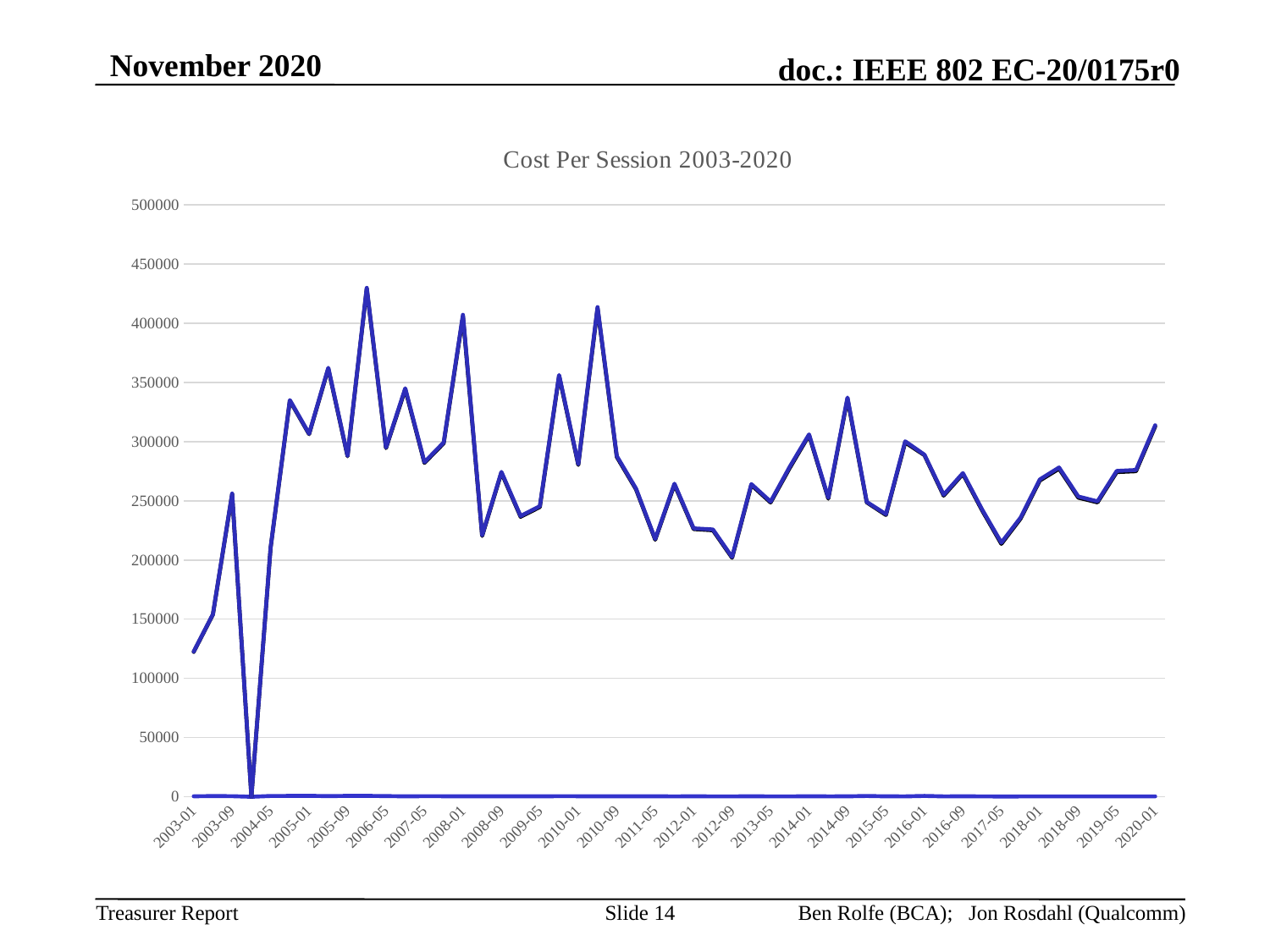
Which has the larger value, 2003-01 or 2020-01? 2020-01 What kind of chart is shown on the slide? line chart What is the title of the chart? Cost Per Session 2003-2020 Is the value for 2020-01 greater or less than 300000? greater Does the line ever rise above 450000? No Does the line rise or fall between 2017-05 and 2020-01? rise Does the line rise or fall between 2003-01 and 2003-09? rise What is the maximum value shown on the vertical axis? 500000 Is the value for 2003-01 greater or less than 150000? less